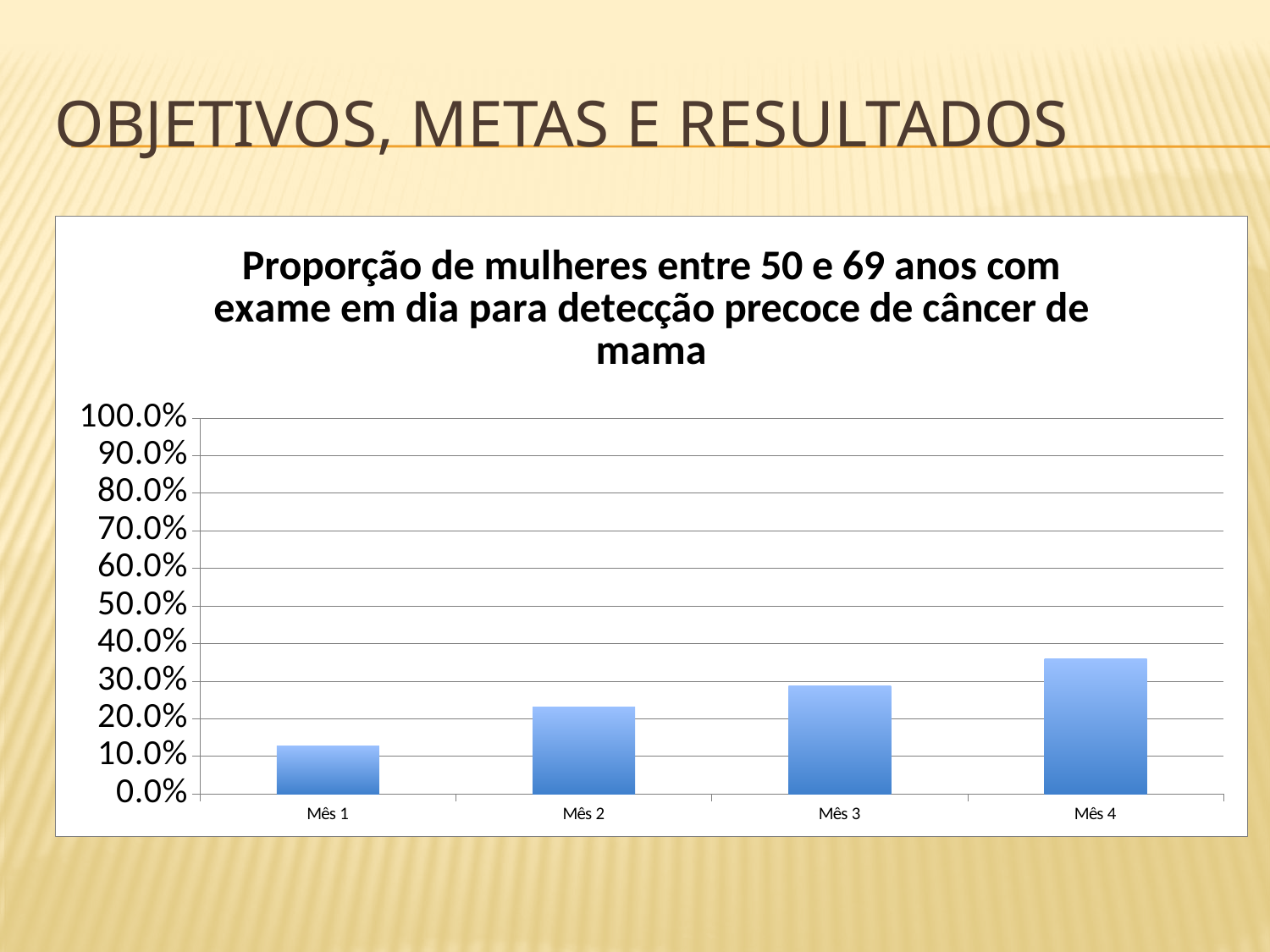
Which is larger, the value for Mês 1 or the value for Mês 4? Mês 4 Is the value for Mês 1 greater or less than 20.0%? less What is the title of the chart? Proporção de mulheres entre 50 e 69 anos com exame em dia para detecção precoce de câncer de mama Is the value for Mês 4 greater or less than 40.0%? less How many categories (months) are plotted on the x axis? 4 Is the value for Mês 4 greater or less than 30.0%? greater Which is larger, the value for Mês 2 or the value for Mês 3? Mês 3 Which month has the highest proportion? Mês 4 What kind of chart is shown on the slide? bar chart Which month has the lowest proportion? Mês 1 Do the values rise or fall from Mês 1 to Mês 4? rise